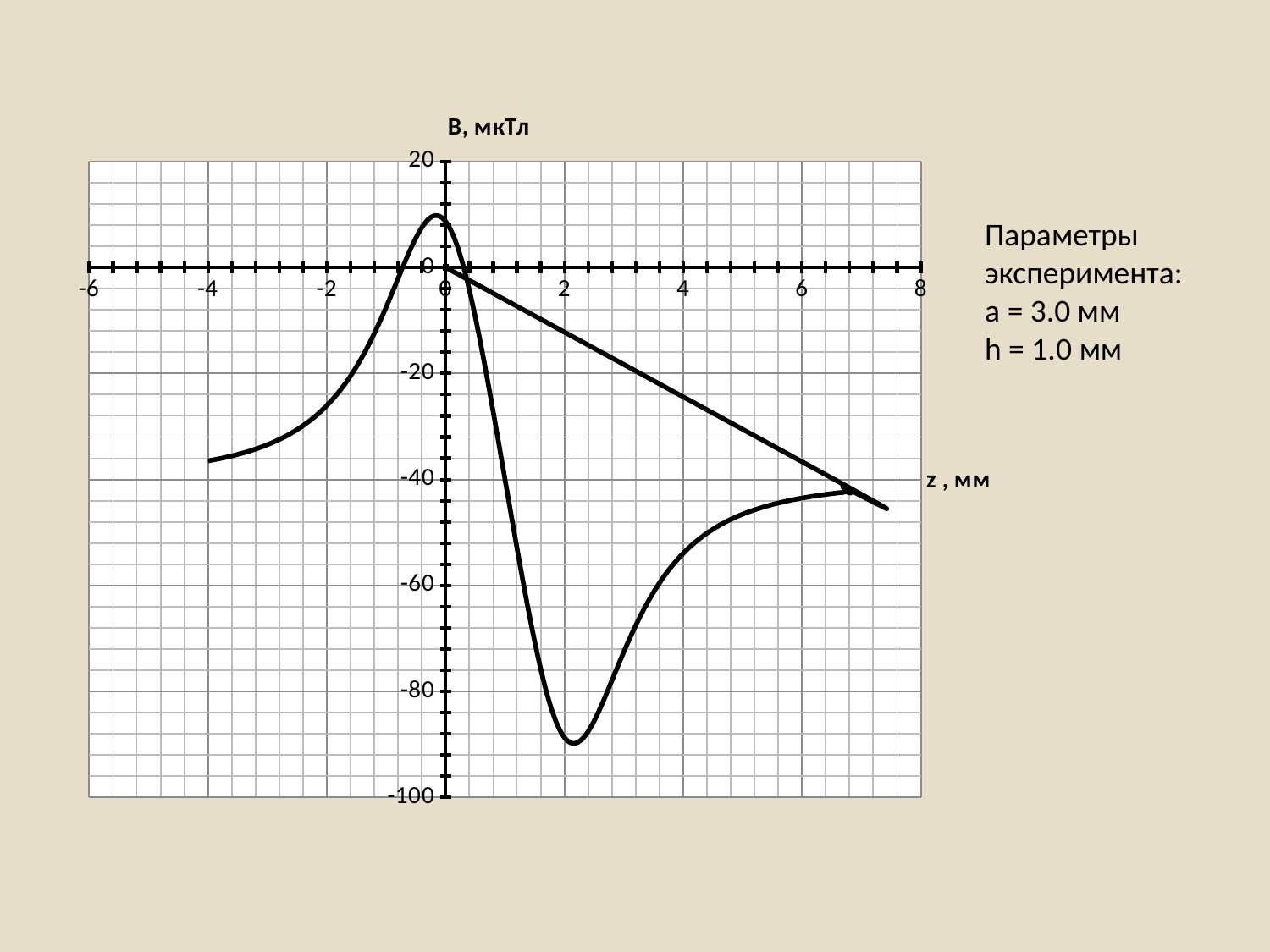
Is the peak value of the curve near z = 0 greater or less than 20? less Does the curve rise or fall as z goes from 0 to 2? fall Does the curve rise or fall as z goes from 2 to 6? rise Is the value of the curve at z = 2 greater or less than -80? less What is the label of the horizontal axis? z , мм Is the value of the curve at z = -4 greater or less than -40? greater Which is larger, the value of the curve at z = -4 or at z = 2? z = -4 Which is larger, the value of the curve at z = -2 or at z = 4? z = -2 What kind of chart is shown on the slide? line chart What is the label of the vertical axis? B, мкТл